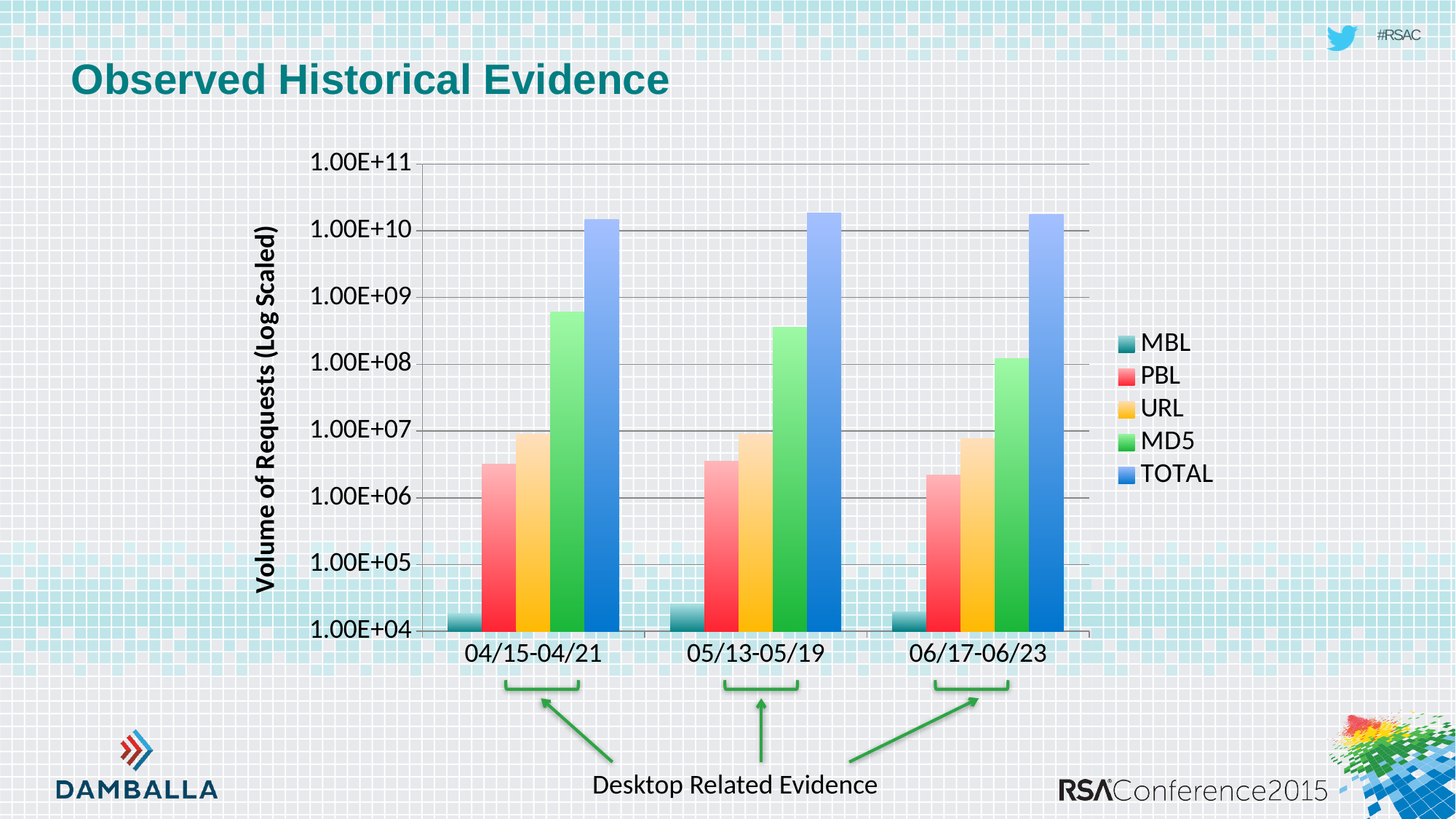
Is the MD5 value for 04/15-04/21 greater or less than 1.00E+08? greater Which series has the lowest value in the 05/13-05/19 period? MBL Is the TOTAL value for 05/13-05/19 greater or less than 1.00E+10? greater What kind of chart is shown on the slide? bar chart In the 05/13-05/19 period, which is larger, MD5 or URL? MD5 What is the label of the vertical axis? Volume of Requests (Log Scaled) Which series has the highest value in the 04/15-04/21 period? TOTAL How many series does the legend list? 5 Is the MBL value for 06/17-06/23 greater or less than 1.00E+05? less How many time periods are shown on the x axis? 3 Does the MD5 value rise or fall across the three periods from 04/15-04/21 to 06/17-06/23? fall Which series is shown in green in the legend? MD5